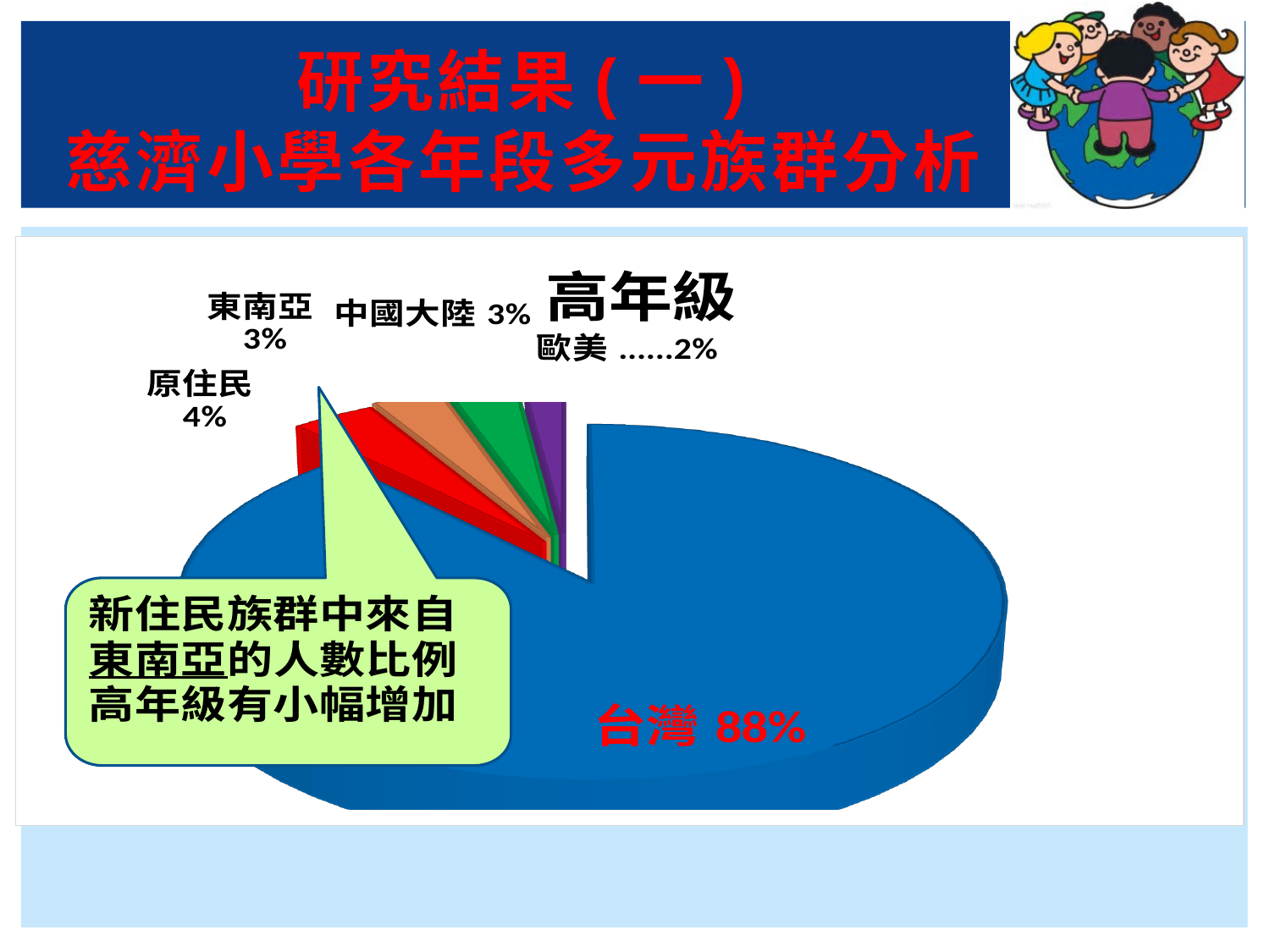
Which category has the largest slice of the pie? 台灣 Which is larger, the share for 原住民 or the share for 歐美? 原住民 What share of the pie does 台灣 represent? 88% What is the value shown for 中國大陸? 3% What is the title of the pie chart? 高年級 What is the value shown for 歐美? 2% What is the difference in percentage points between 台灣 and 原住民? 84 Which category has the smallest slice of the pie? 歐美 What is the value shown for 原住民? 4% What kind of chart is shown on the slide? pie chart How many categories are shown in the pie chart? 5 What is the value shown for 東南亞? 3%